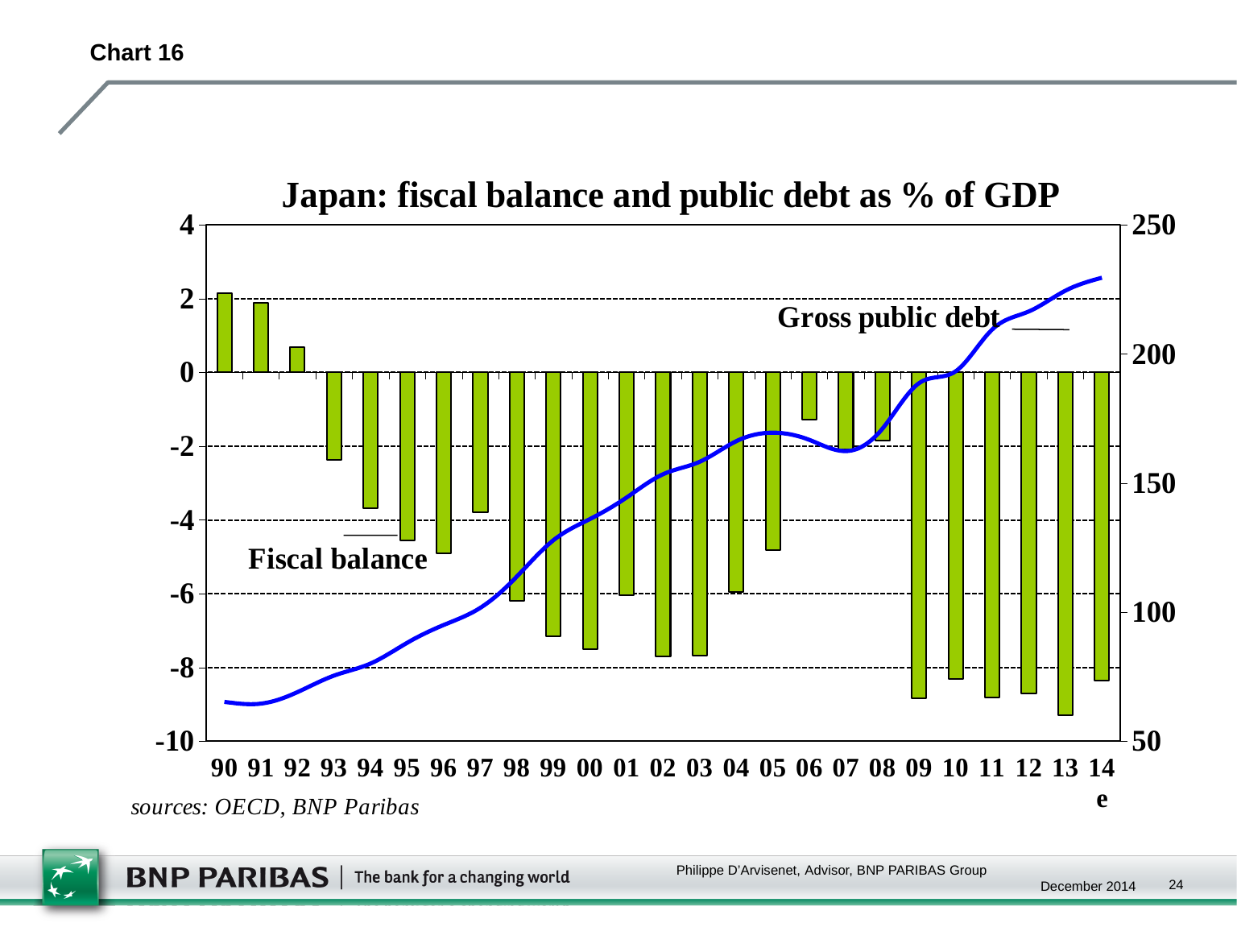
What is the title of the chart? Japan: fiscal balance and public debt as % of GDP Is the fiscal balance for 06 greater or less than -2? greater Is the fiscal balance for 93 greater or less than -2? less Does the gross public debt line rise or fall from 90 to 14e? rise How many years are shown on the x axis of the chart? 25 Is the fiscal balance for 99 greater or less than -6? less Which year has the larger fiscal balance, 90 or 93? 90 Which year has the lowest fiscal balance in the chart? 13 What kind of chart is shown on the slide? A combined bar and line chart Which series is plotted as a line in the chart? Gross public debt